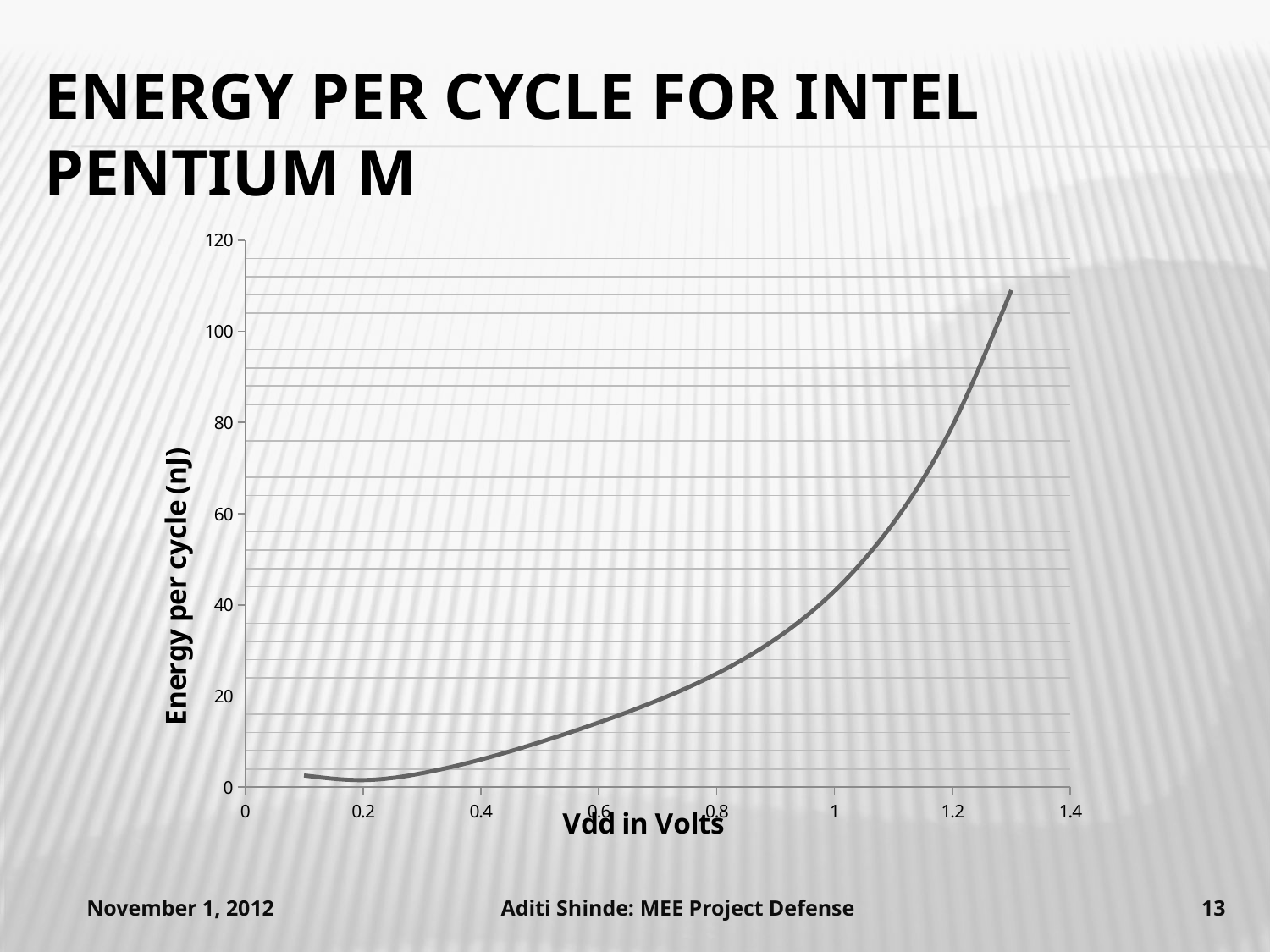
Is the energy per cycle at Vdd = 0.2 volts greater or less than 20? less Is the energy per cycle higher at Vdd = 1.2 volts or at Vdd = 0.8 volts? 1.2 volts Is the energy per cycle at Vdd = 0.8 volts greater or less than 40? less Is the energy per cycle at Vdd = 1 volt greater or less than 20? greater Is the energy per cycle higher at Vdd = 0.4 volts or at Vdd = 1 volt? 1 volt Does the energy per cycle rise or fall as Vdd increases from 0.4 to 1.2 volts? rise What kind of chart is shown on the slide? line chart What is the label of the y axis? Energy per cycle (nJ) What is the title of the chart? Energy per cycle for Intel Pentium M